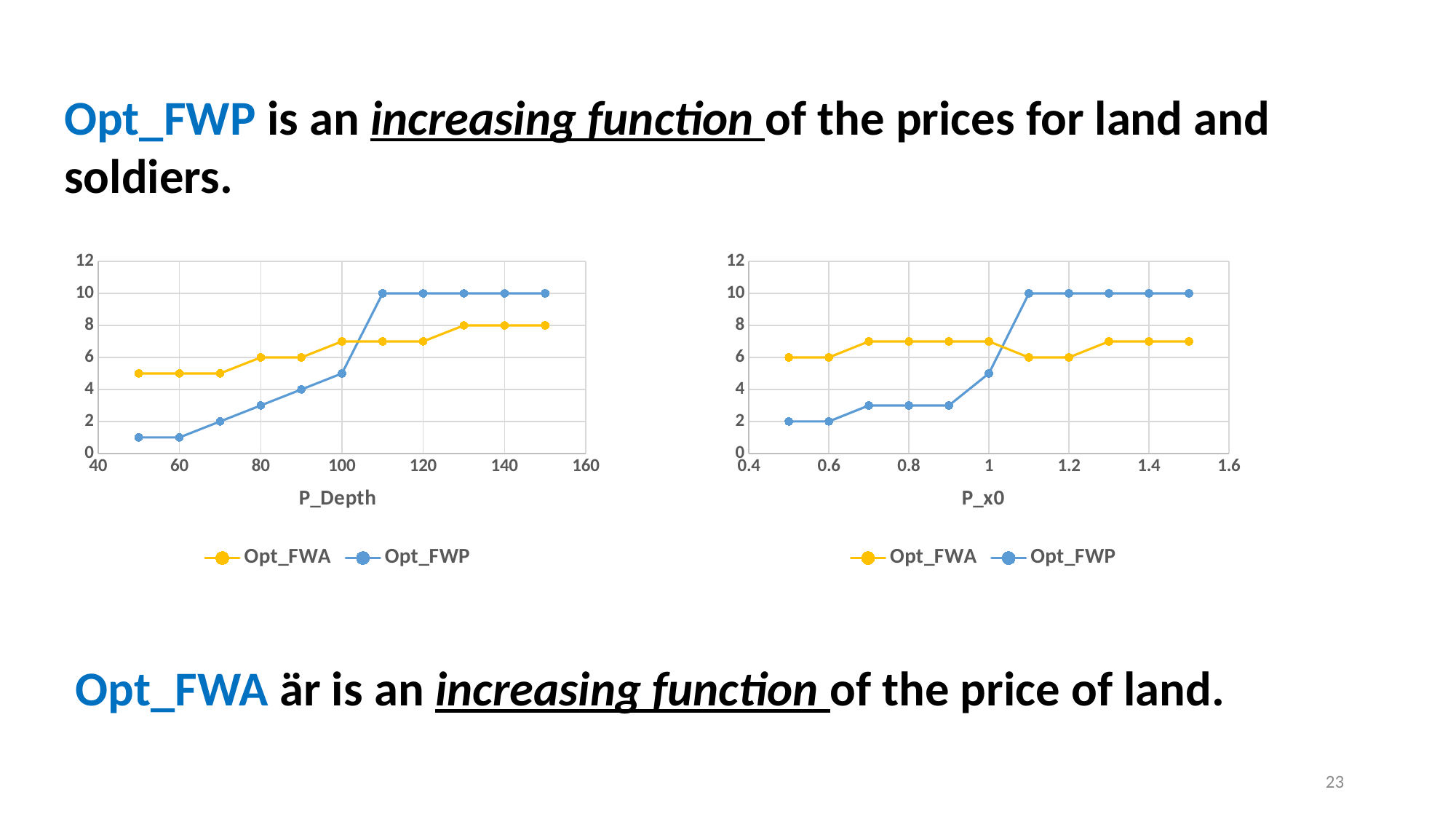
In the right chart (P_x0), what is the value of Opt_FWP at P_x0 0.5? 2 In the left chart (P_Depth), what is the value of Opt_FWP at P_Depth 110? 10 In the left chart (P_Depth), how many data points does the Opt_FWP series have? 11 In the left chart (P_Depth), what is the value of Opt_FWP at P_Depth 70? 2 How many series does the legend of the right chart (P_x0) list? 2 In the left chart (P_Depth), what is the value of Opt_FWA at P_Depth 80? 6 What kind of chart is the left chart (P_Depth)? line chart In the left chart (P_Depth), which series has the larger value at P_Depth 150, Opt_FWA or Opt_FWP? Opt_FWP In the right chart (P_x0), what is the value of Opt_FWA at P_x0 0.6? 6 In the left chart (P_Depth), what is the difference between the Opt_FWP values at P_Depth 110 and P_Depth 70? 8 In the left chart (P_Depth), is the value of Opt_FWA at P_Depth 50 greater or less than 4? greater In the right chart (P_x0), does the Opt_FWP series generally rise or fall as P_x0 increases? rise